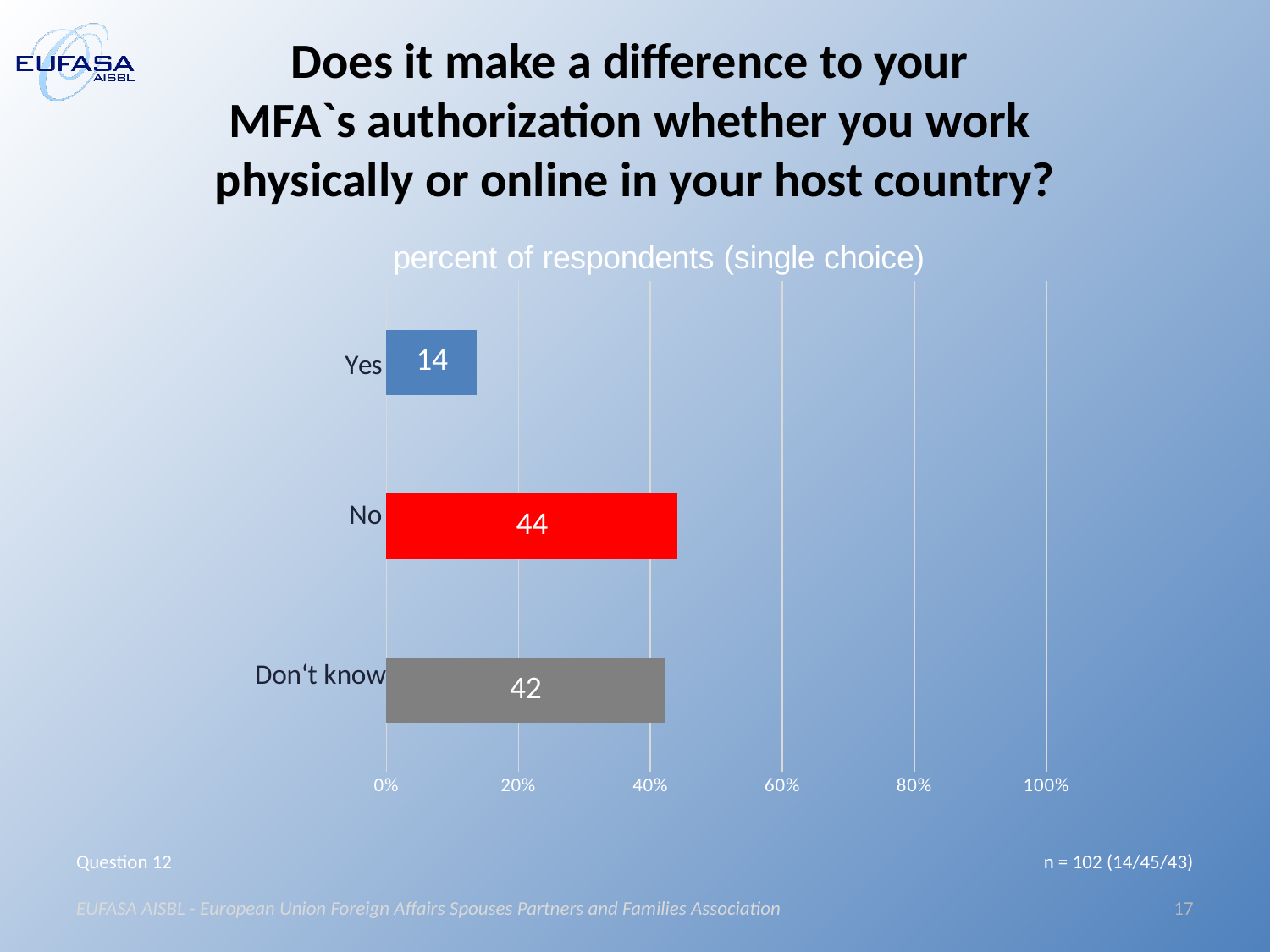
What is the value for "No"? 44 Which category has the highest value? No What is the value for "Yes"? 14 What is the difference between the values for "No" and "Don't know"? 2 Is the value for "No" greater or less than 40%? greater What is the title of the chart? percent of respondents (single choice) How many categories are shown in the chart? 3 Which is larger, the value for "Don't know" or the value for "Yes"? Don't know What is the difference between the values for "No" and "Yes"? 30 What is the value for "Don't know"? 42 What kind of chart is shown on the slide? bar chart Which category has the lowest value? Yes